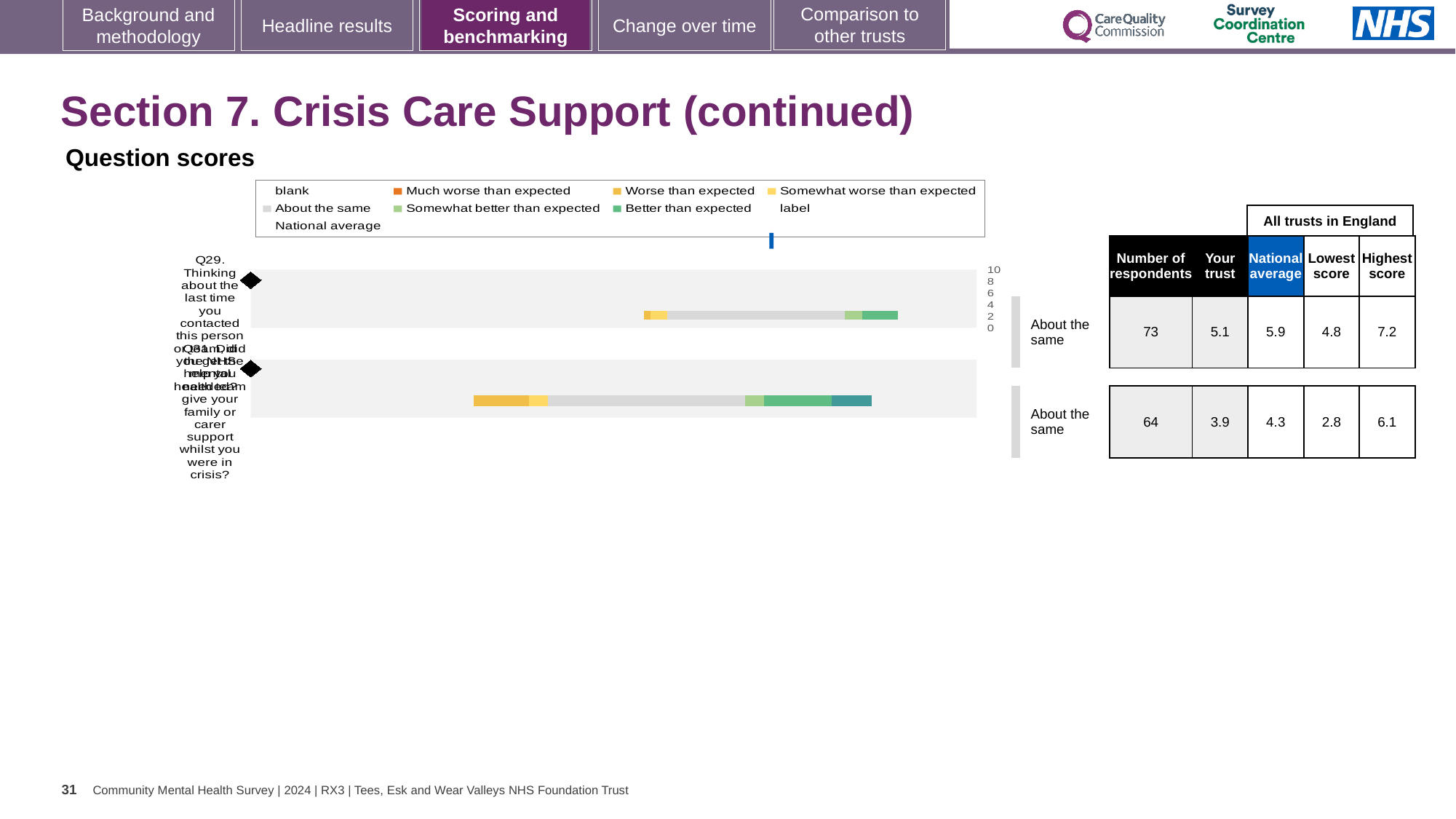
What is the national average score for Q29? 5.9 What kind of chart is shown on the slide? bar chart What is the 'Your trust' score for Q31? 3.9 What is the highest score among all trusts in England for Q31? 6.1 How many respondents answered Q29? 73 Which question has the higher 'Your trust' score, Q29 or Q31? Q29 How many questions are plotted in the chart? 2 What is the difference between the national average and the trust score for Q31? 0.4 How is the trust's result for Q29 categorised relative to expectations? About the same What is the lowest score among all trusts in England for Q29? 4.8 What is the 'Your trust' score for Q29? 5.1 What is the maximum value shown on the chart's score axis? 10